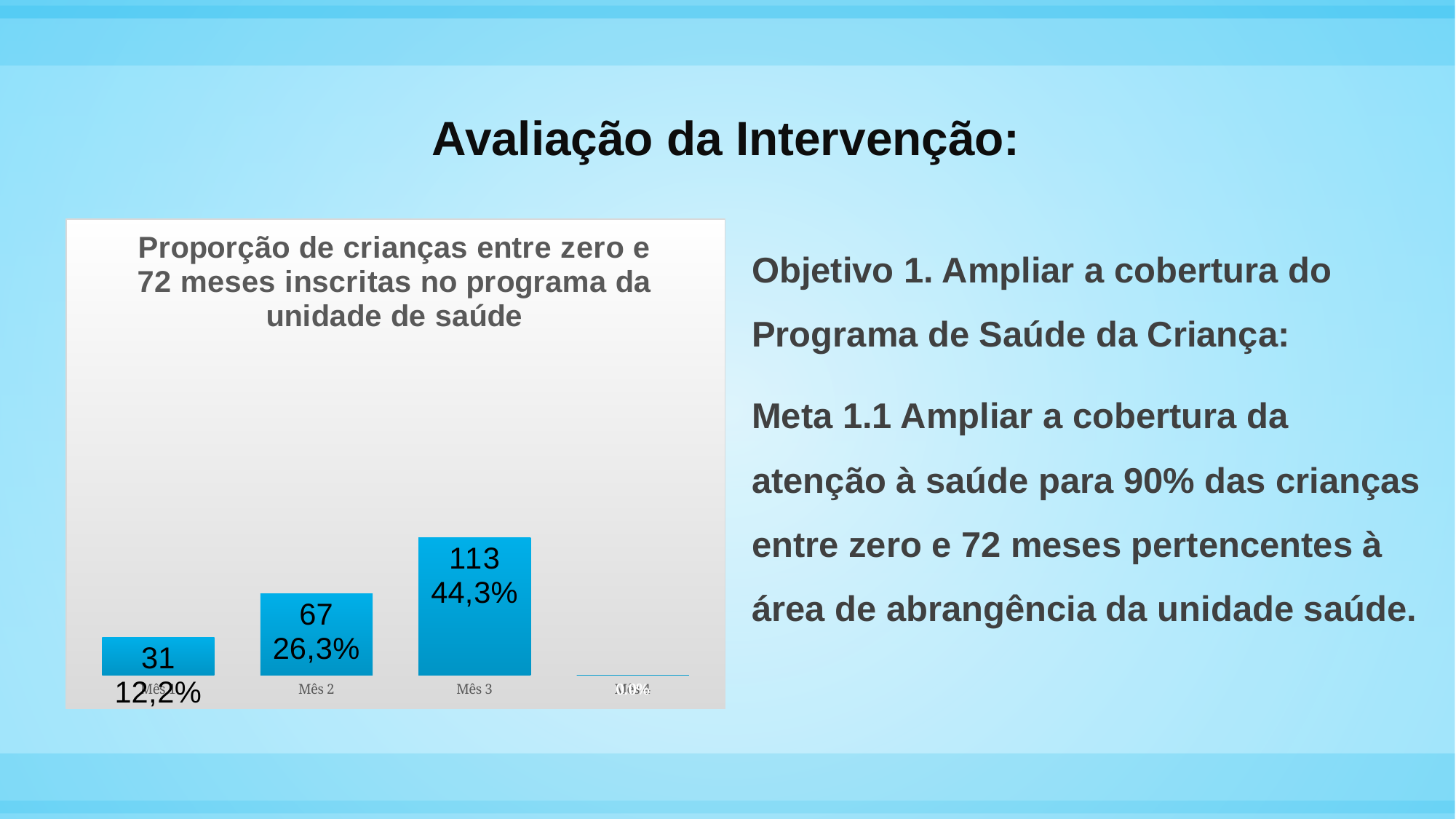
What is the difference in the number of children between Mês 3 and Mês 2? 46 What is the number of children shown for Mês 1? 31 What kind of chart is shown on the slide? bar chart What is the number of children shown for Mês 3? 113 What percentage is shown for Mês 2? 26,3% What is the title of the chart? Proporção de crianças entre zero e 72 meses inscritas no programa da unidade de saúde Which is larger, the value for Mês 2 or the value for Mês 3? Mês 3 What is the difference in the number of children between Mês 2 and Mês 1? 36 Which month with a plotted bar has the lowest value? Mês 1 Do the values rise or fall from Mês 1 to Mês 3? rise What percentage is shown for Mês 3? 44,3% Which month has the highest bar? Mês 3